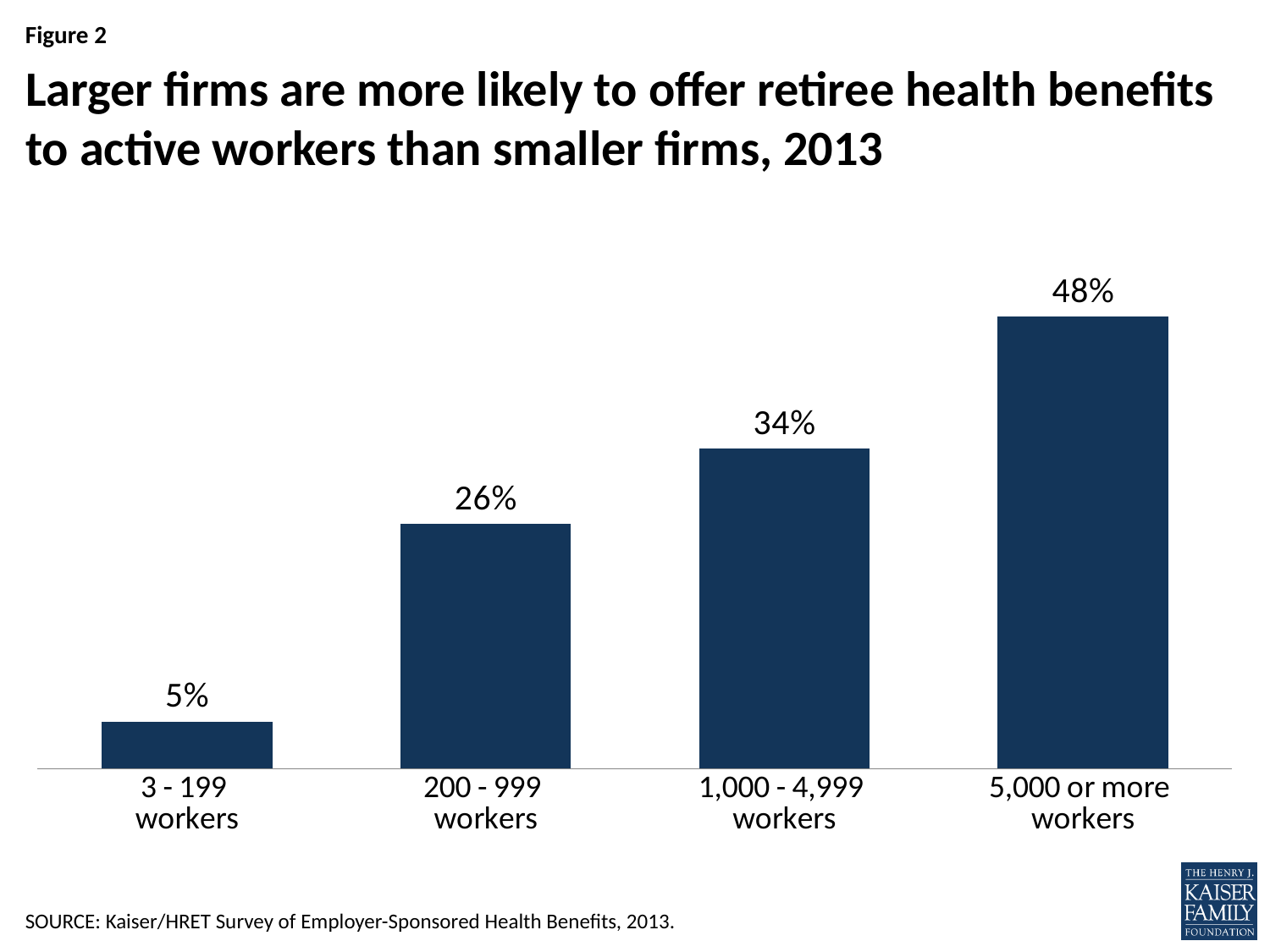
What is the value shown for firms with 1,000 - 4,999 workers? 34% Do the values rise or fall as firm size increases along the x axis? Rise Which firm size category has the highest value? 5,000 or more workers What is the value shown for firms with 200 - 999 workers? 26% Which is larger: the value for 200 - 999 workers or the value for 1,000 - 4,999 workers? 1,000 - 4,999 workers What is the difference between the values for firms with 1,000 - 4,999 workers and firms with 200 - 999 workers? 8% Which firm size category has the lowest value? 3 - 199 workers What kind of chart is shown on the slide? Bar chart What is the value shown for firms with 5,000 or more workers? 48% What percentage of firms with 3 - 199 workers offer retiree health benefits? 5% What is the difference between the values for firms with 5,000 or more workers and firms with 3 - 199 workers? 43% How many firm size categories are shown in the chart? 4